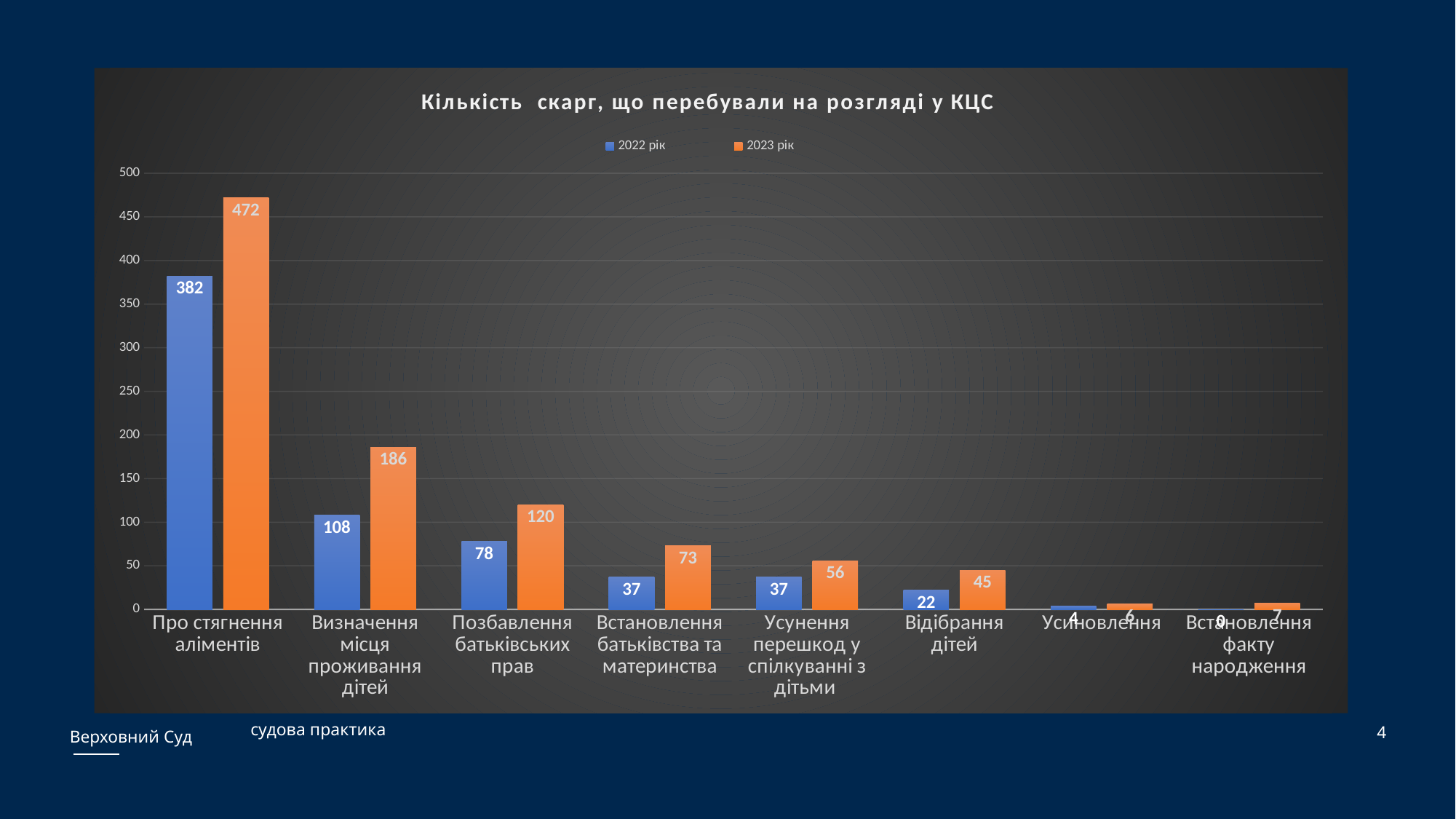
What is the value for 2023 рік for Визначення місця проживання дітей? 186 What is the difference between the 2023 рік and 2022 рік values for Про стягнення аліментів? 90 What is the difference between the 2023 рік and 2022 рік values for Встановлення батьківства та материнства? 36 Which is larger for Усунення перешкод у спілкуванні з дітьми: the 2022 рік value or the 2023 рік value? 2023 рік Which category has the highest value for 2023 рік? Про стягнення аліментів What type of chart is shown on the slide? bar chart What is the value for 2022 рік for Про стягнення аліментів? 382 How many series does the legend list? 2 What is the value for 2022 рік for Позбавлення батьківських прав? 78 What is the value for 2023 рік for Відібрання дітей? 45 Is the 2023 рік value for Позбавлення батьківських прав greater or less than 100? greater How many categories are shown on the x axis? 8